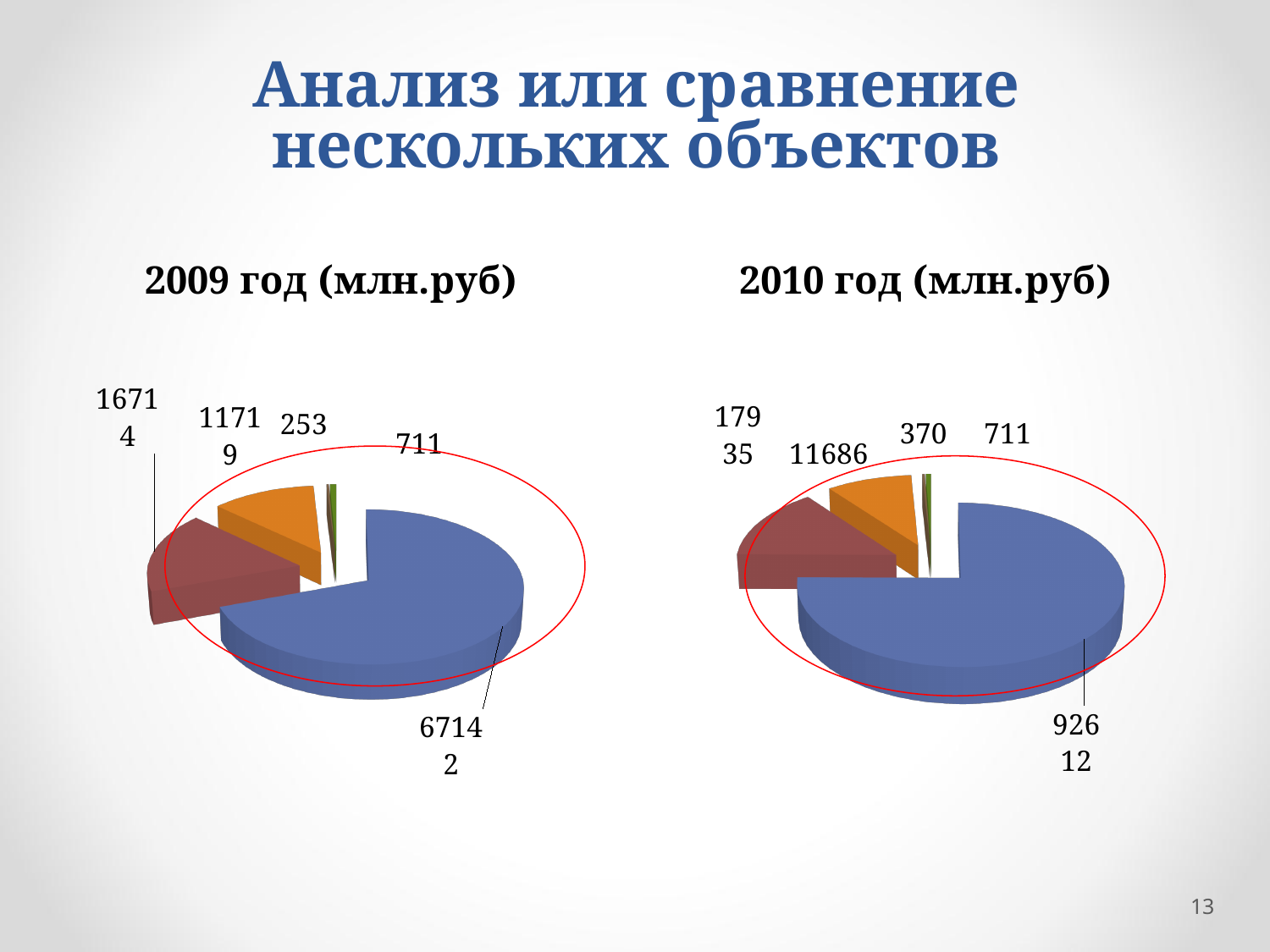
What kind of chart is used for the 2009 год (млн.руб) data? pie chart What is the total of all slices in the 2009 год (млн.руб) pie chart? 96539 What is the total of all slices in the 2010 год (млн.руб) pie chart? 123314 In the 2010 год (млн.руб) chart, what is the value of the orange slice? 11686 In the 2009 год (млн.руб) chart, what is the value of the red slice? 16714 In the 2010 год (млн.руб) chart, what is the smallest value shown? 370 How many slices does the 2010 год (млн.руб) pie chart have? 5 In the 2010 год (млн.руб) chart, what is the difference between the blue slice (92612) and the red slice (17935)? 74677 In the 2009 год (млн.руб) chart, what is the value of the largest (blue) slice? 67142 In the 2009 год (млн.руб) chart, what is the difference between the blue slice (67142) and the red slice (16714)? 50428 In the 2010 год (млн.руб) chart, what is the value of the largest (blue) slice? 92612 In the 2009 год (млн.руб) chart, what is the smallest value shown? 253